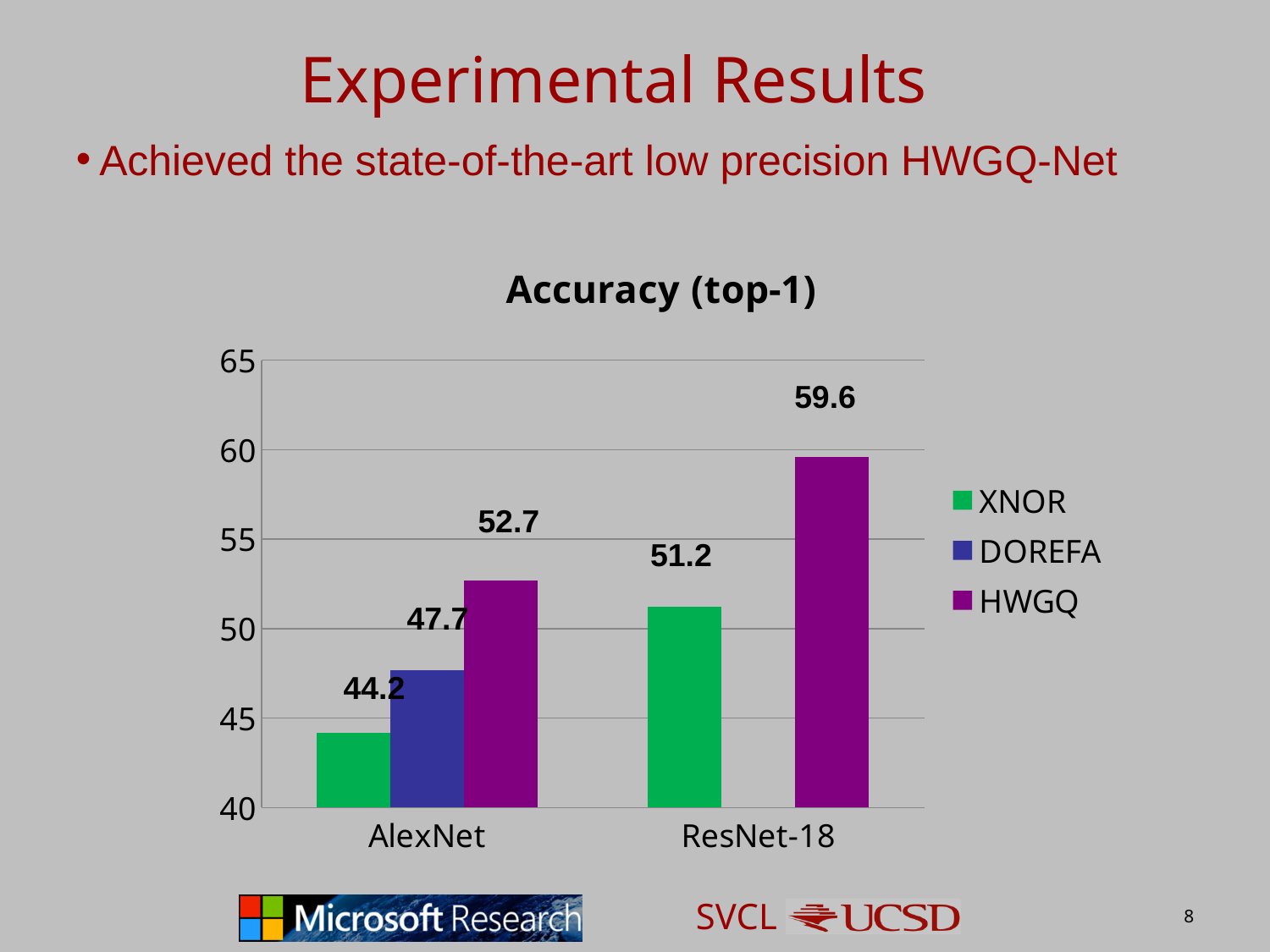
What is the top-1 accuracy of XNOR on ResNet-18? 51.2 What is the top-1 accuracy of HWGQ on AlexNet? 52.7 What is the difference in top-1 accuracy between HWGQ and XNOR on ResNet-18? 8.4 What is the top-1 accuracy of XNOR on AlexNet? 44.2 Which method has the highest top-1 accuracy on ResNet-18? HWGQ What kind of chart is shown on the slide? Bar chart How many series does the legend list? 3 Which is larger: the XNOR accuracy on ResNet-18 or the HWGQ accuracy on AlexNet? HWGQ accuracy on AlexNet Which method has the lowest top-1 accuracy on AlexNet? XNOR What is the top-1 accuracy of DOREFA on AlexNet? 47.7 What is the title of the chart? Accuracy (top-1) What is the difference in top-1 accuracy between HWGQ and DOREFA on AlexNet? 5.0